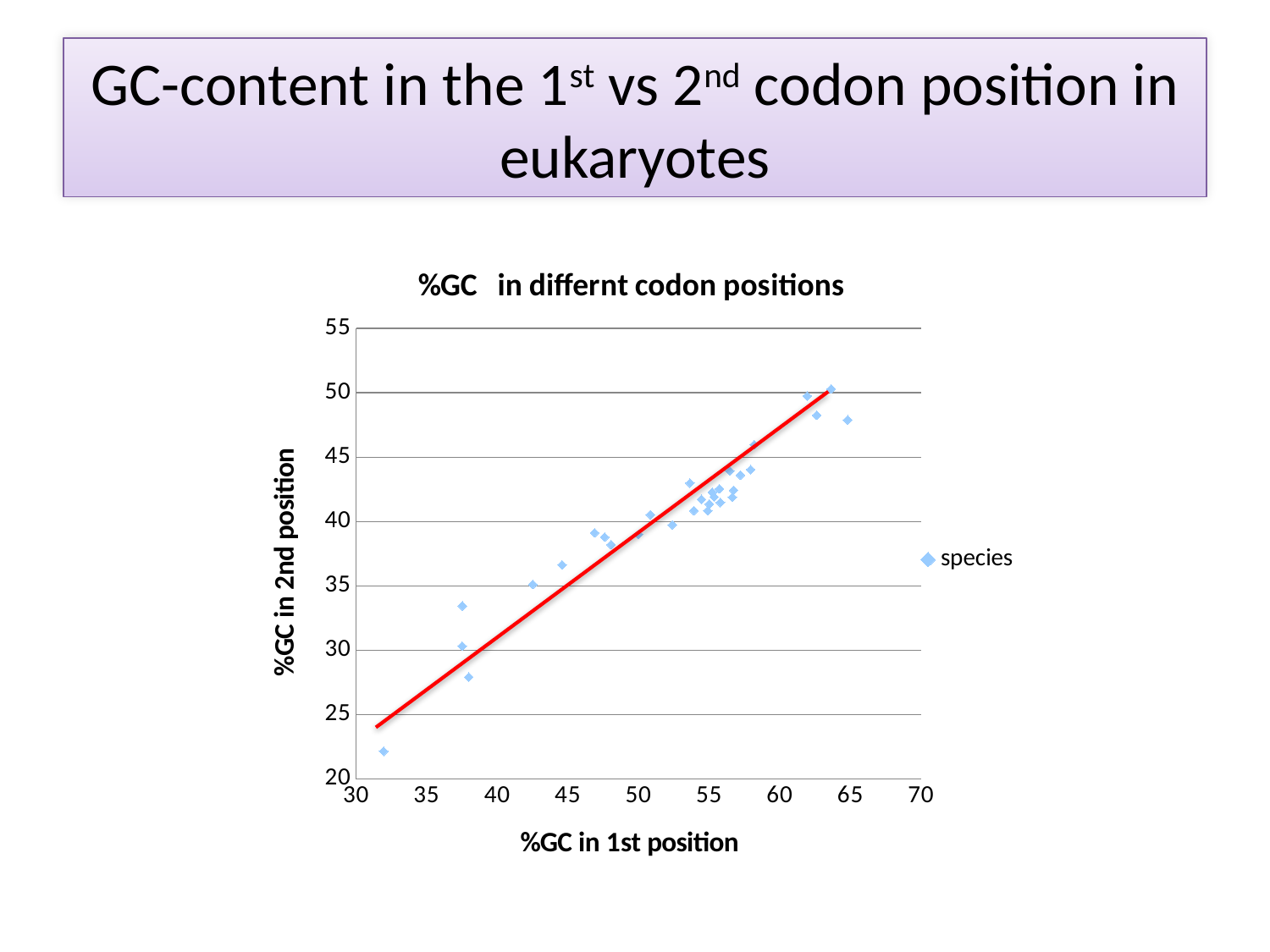
As %GC in 1st position increases along the x axis, does %GC in 2nd position generally rise or fall? rise Is the %GC in 2nd position for the rightmost point greater or less than 50? less How many series does the legend list? 1 Are there any points with %GC in 2nd position greater than 55? no Is the %GC in 2nd position for the leftmost point (lowest %GC in 1st position) greater or less than 25? less What is the title of the chart? %GC in differnt codon positions Which point has the higher %GC in 2nd position: the leftmost point or the rightmost point? the rightmost point What is the name of the series shown in the legend? species What kind of chart is shown on the slide? scatter plot